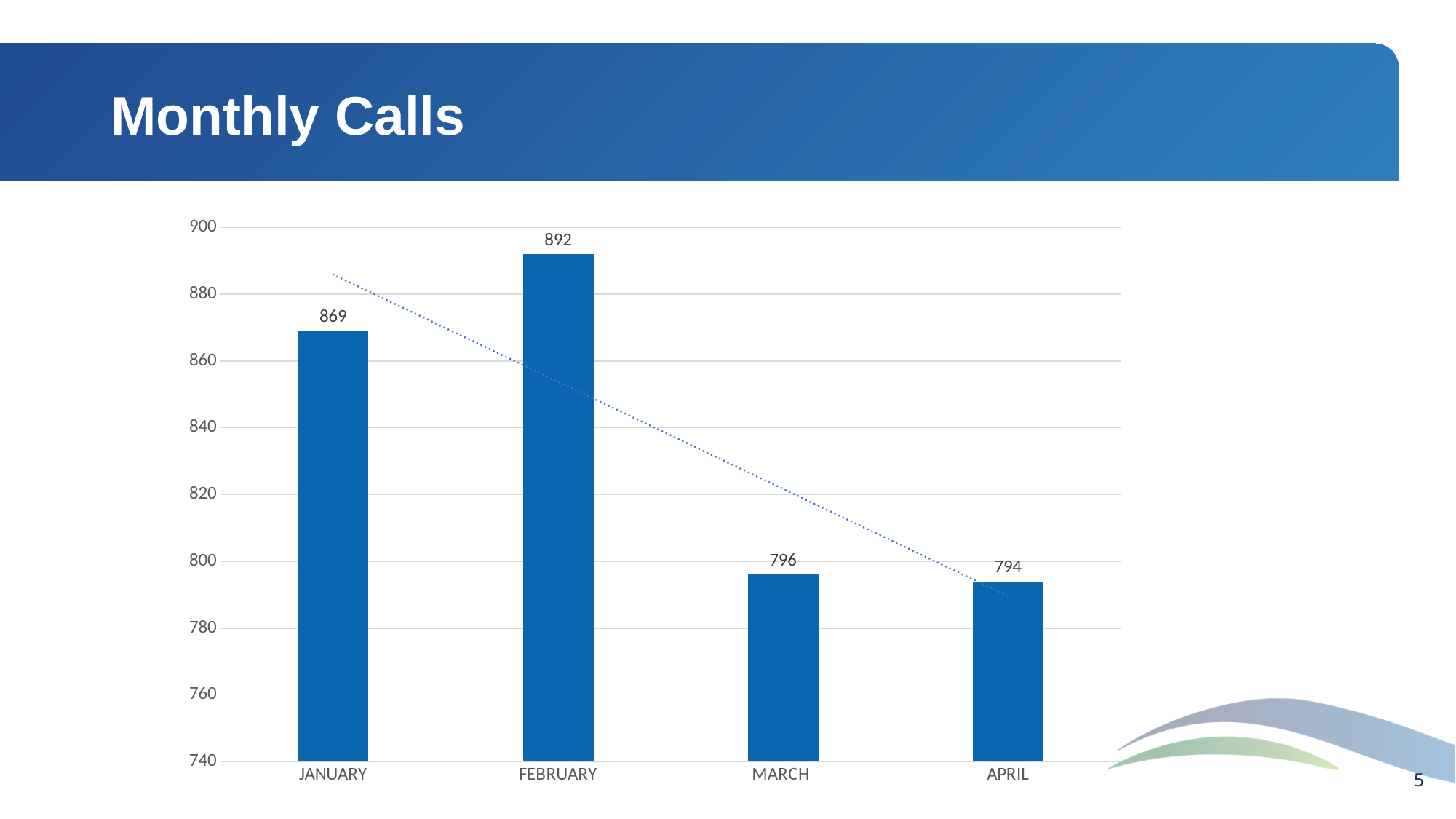
What is the difference between the values for February and January? 23 What is the value for February? 892 What is the difference between the values for March and April? 2 Which month has the lowest value? April How many months are shown on the chart? 4 What is the value for January? 869 What kind of chart is shown on the slide? Bar chart Which month has the highest value? February What is the title of the slide containing the chart? Monthly Calls What is the value for April? 794 Which is larger, the value for January or the value for March? January What is the value for March? 796